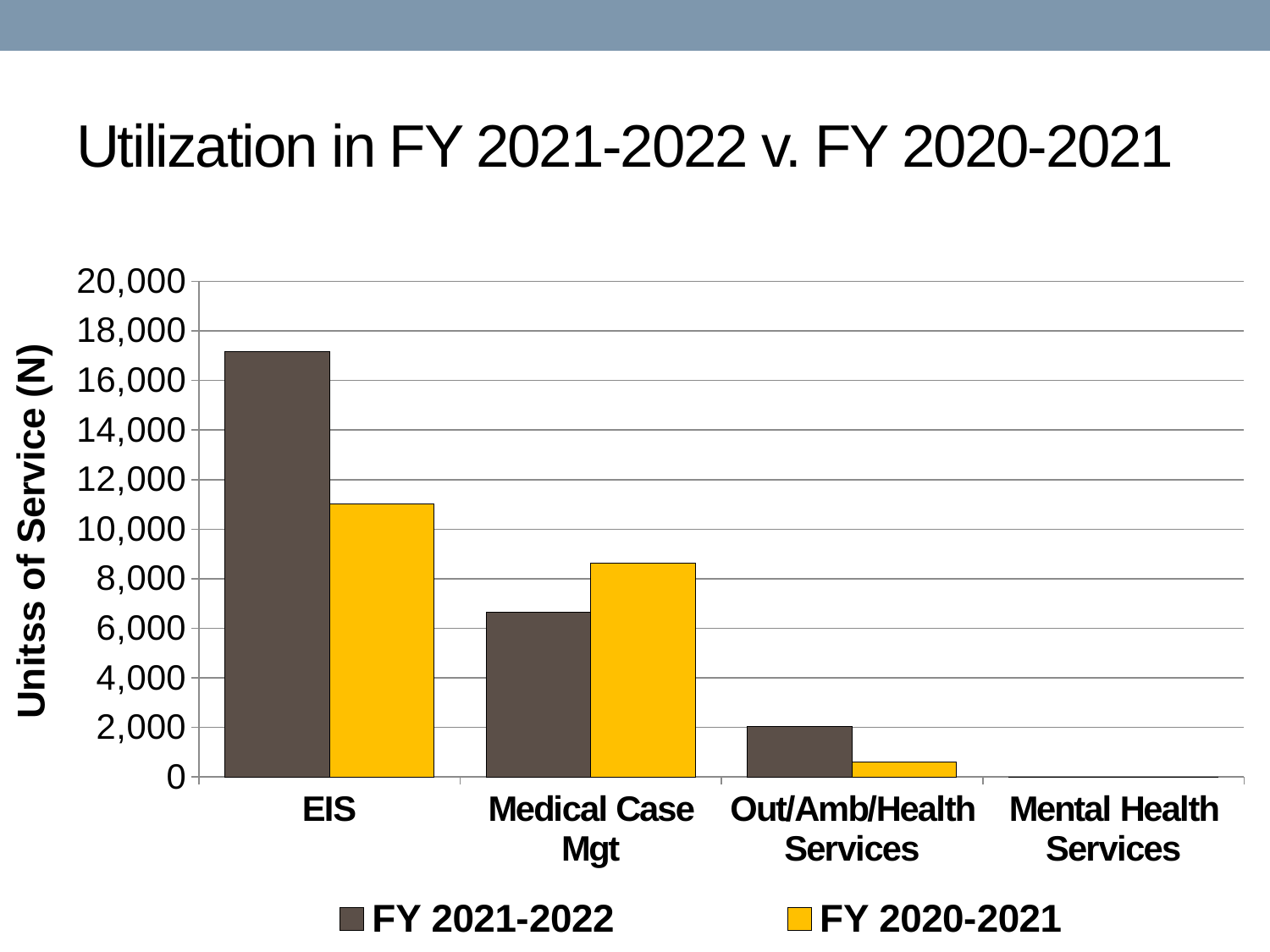
Which category has the lowest FY 2020-2021 value? Mental Health Services Is the FY 2020-2021 value for EIS greater or less than 12,000? less Is the FY 2020-2021 value for Medical Case Mgt greater or less than 8,000? greater How many series does the legend list? 2 Which category has the highest FY 2021-2022 value? EIS For Medical Case Mgt, which series has the larger value, FY 2021-2022 or FY 2020-2021? FY 2020-2021 Is the FY 2021-2022 value for EIS greater or less than 16,000? greater For Out/Amb/Health Services, which series has the larger value, FY 2021-2022 or FY 2020-2021? FY 2021-2022 What is the title of the chart? Utilization in FY 2021-2022 v. FY 2020-2021 What type of chart is shown on the slide? bar chart How many categories are shown on the x axis? 4